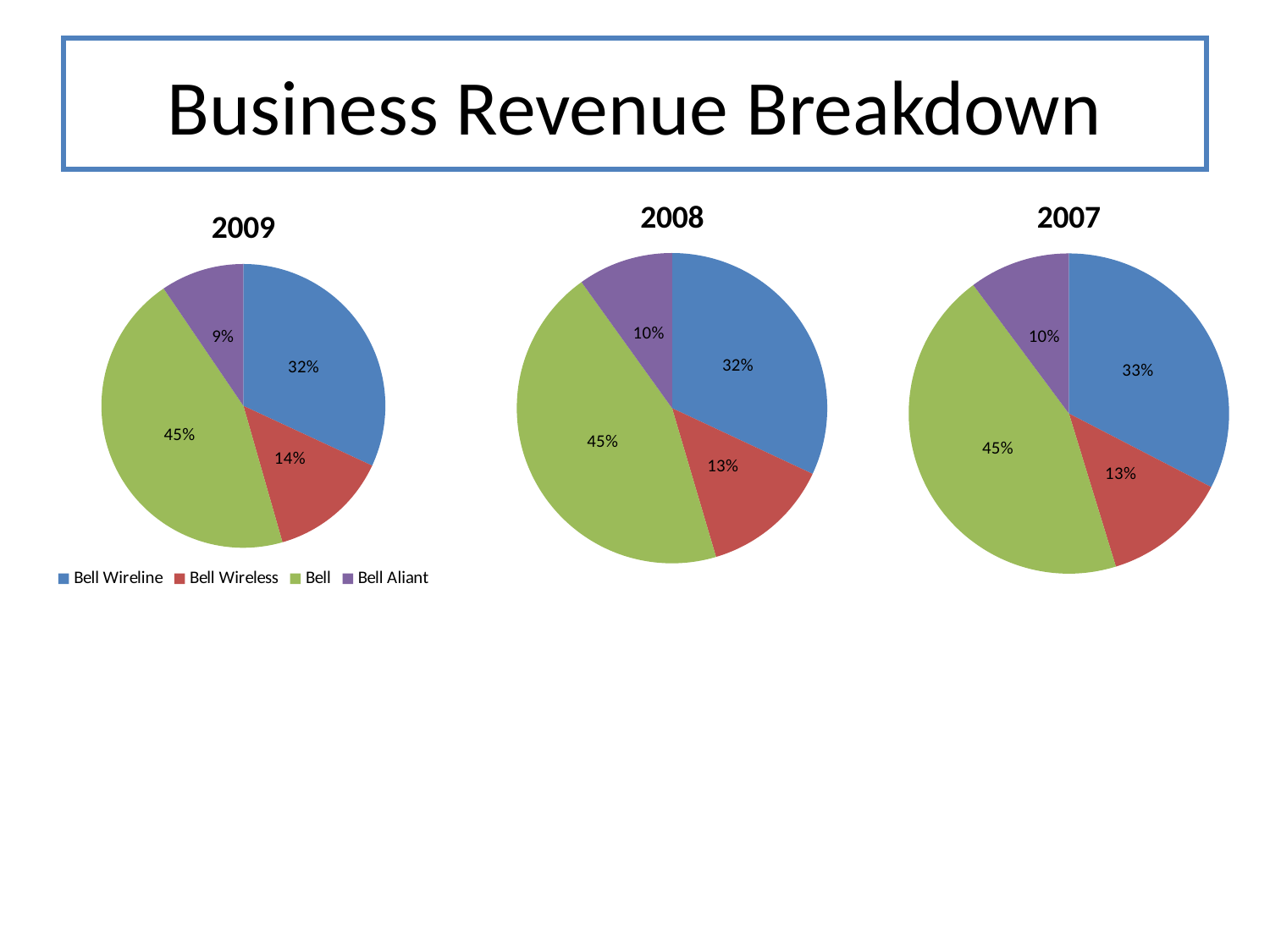
In the 2008 pie chart, what share does Bell Wireless have? 13% In the 2007 pie chart, what share does Bell Wireline have? 33% In the 2009 pie chart, what share does Bell Aliant have? 9% In the 2009 pie chart, which category has the smallest slice? Bell Aliant In the 2008 pie chart, what is the difference between the Bell share and the Bell Wireline share? 13% What kind of chart is used for the 2007 data? Pie chart What colour represents Bell in the pie charts? Green How many slices does the 2008 pie chart have? 4 How many entries does the legend under the 2009 chart list? 4 In the 2009 pie chart, which is larger, the Bell Wireless slice or the Bell Aliant slice? Bell Wireless In the 2007 pie chart, which category has the largest slice? Bell